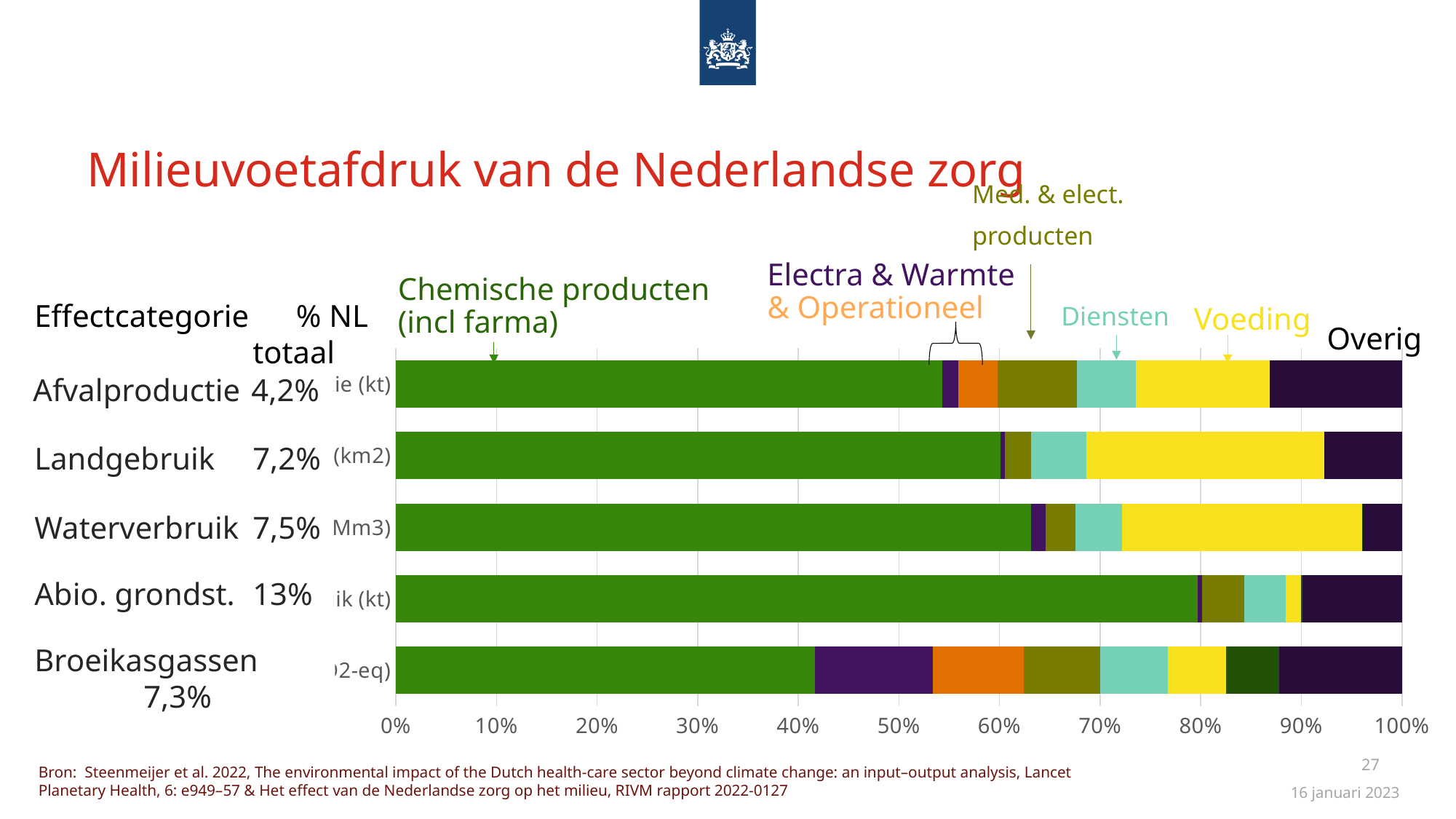
What is the title of the slide containing the chart? Milieuvoetafdruk van de Nederlandse zorg Which has the larger Voeding share: Landgebruik or Abio. grondst.? Landgebruik Is the Chemische producten (incl farma) share for Afvalproductie greater or less than 50%? greater Which effect category has the smallest Voeding share? Abio. grondst. What is the maximum value shown on the chart's horizontal axis? 100% Which effect category has the smallest share for Chemische producten (incl farma)? Broeikasgassen How many effect categories (bars) are plotted in the chart? 5 Which effect category has the largest share for Chemische producten (incl farma)? Abio. grondst. Is the Chemische producten (incl farma) share for Broeikasgassen greater or less than 50%? less Which has the larger Operationeel (orange) share: Afvalproductie or Broeikasgassen? Broeikasgassen Is the Chemische producten (incl farma) share for Abio. grondst. greater or less than 70%? greater What kind of chart is shown on the slide? Stacked bar chart